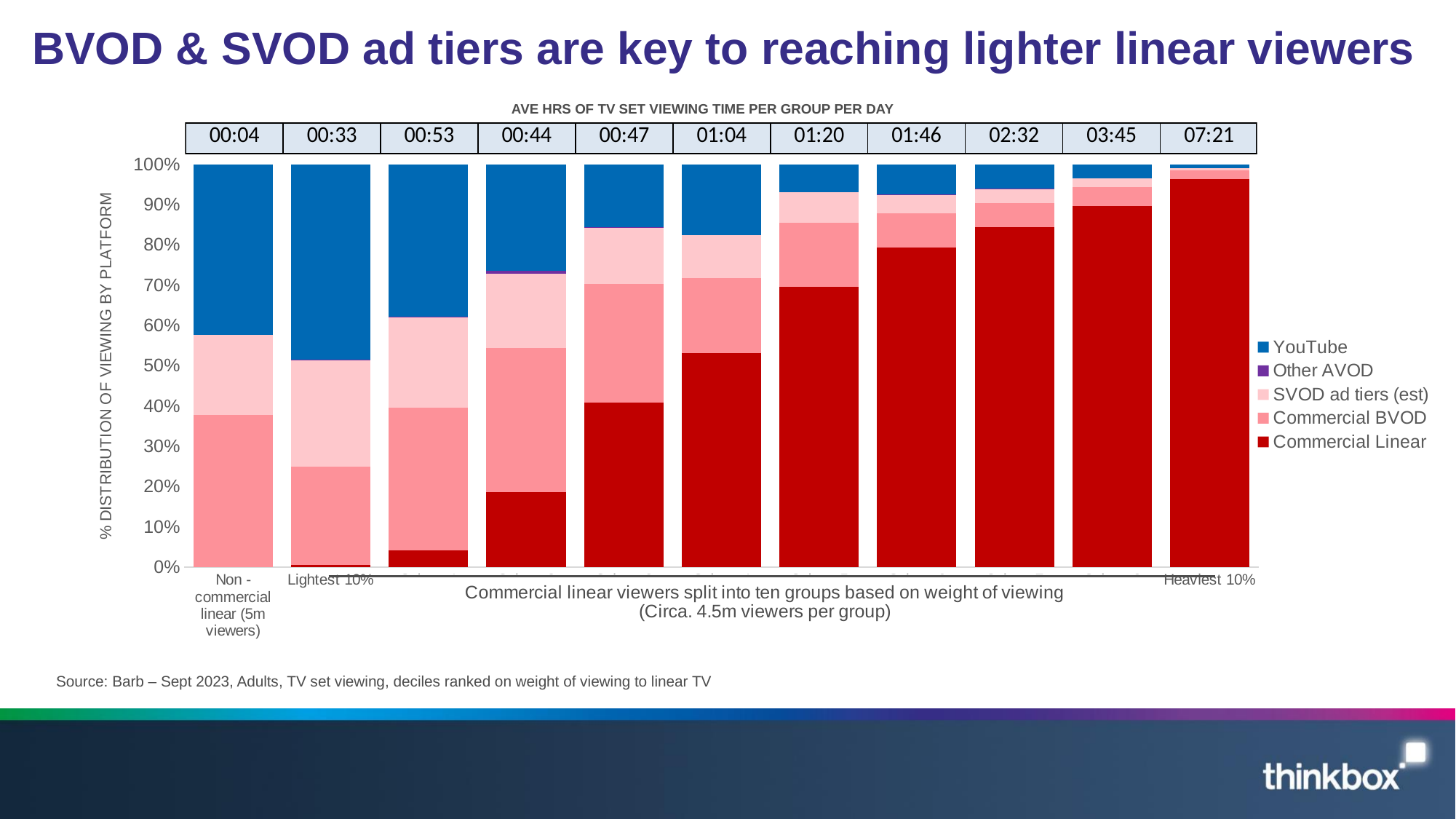
What is the average hours of TV set viewing time per day shown for the Lightest 10% group? 00:33 What kind of chart is shown on the slide? Stacked bar chart Is the Commercial Linear share for the Heaviest 10% group greater or less than 90%? greater What is the average hours of TV set viewing time per day shown for the Non-commercial linear (5m viewers) group? 00:04 Is the Commercial Linear share for the Lightest 10% group greater or less than 10%? less What is the average hours of TV set viewing time per day shown for the Heaviest 10% group? 07:21 Which group has the lowest average hours of TV set viewing time per day? Non-commercial linear (5m viewers) Which series is shown in dark red in the legend? Commercial Linear How many bars (viewer groups) are plotted in the chart? 11 Which group has the highest average hours of TV set viewing time per day? Heaviest 10% Does the Commercial Linear share rise or fall moving from the Lightest 10% group to the Heaviest 10% group? rises How many series does the legend list? 5